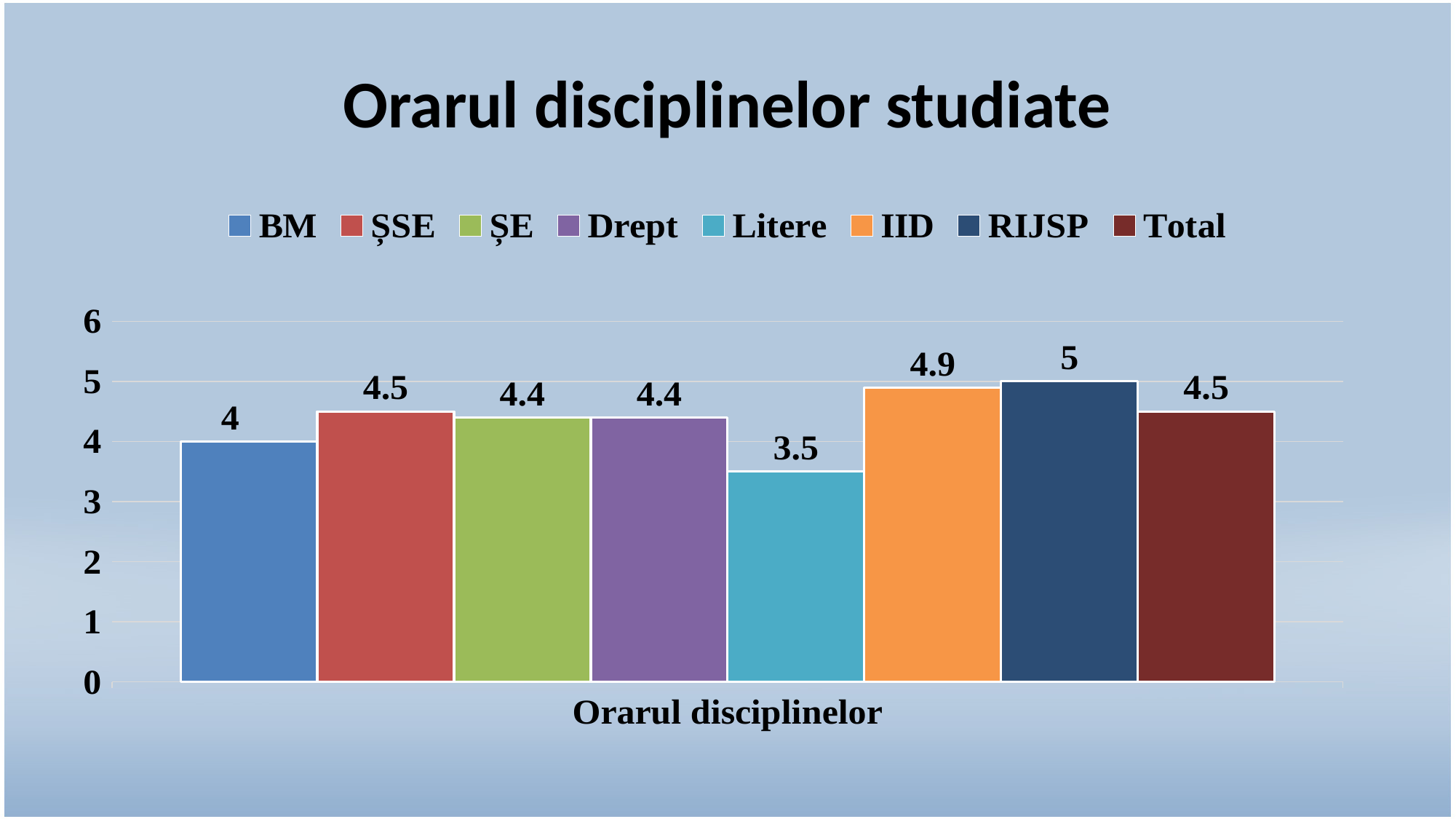
What is the value for BM? 4 What is the value for Litere? 3.5 Which is larger, the value for IID or the value for Drept? IID What is the title of the chart? Orarul disciplinelor studiate What is the value for IID? 4.9 What kind of chart is shown on the slide? bar chart Which series has the highest value? RIJSP Which series has the lowest value? Litere What is the value for Total? 4.5 What is the difference between the values for RIJSP and Litere? 1.5 What is the difference between the values for ȘSE and BM? 0.5 How many series does the legend list? 8